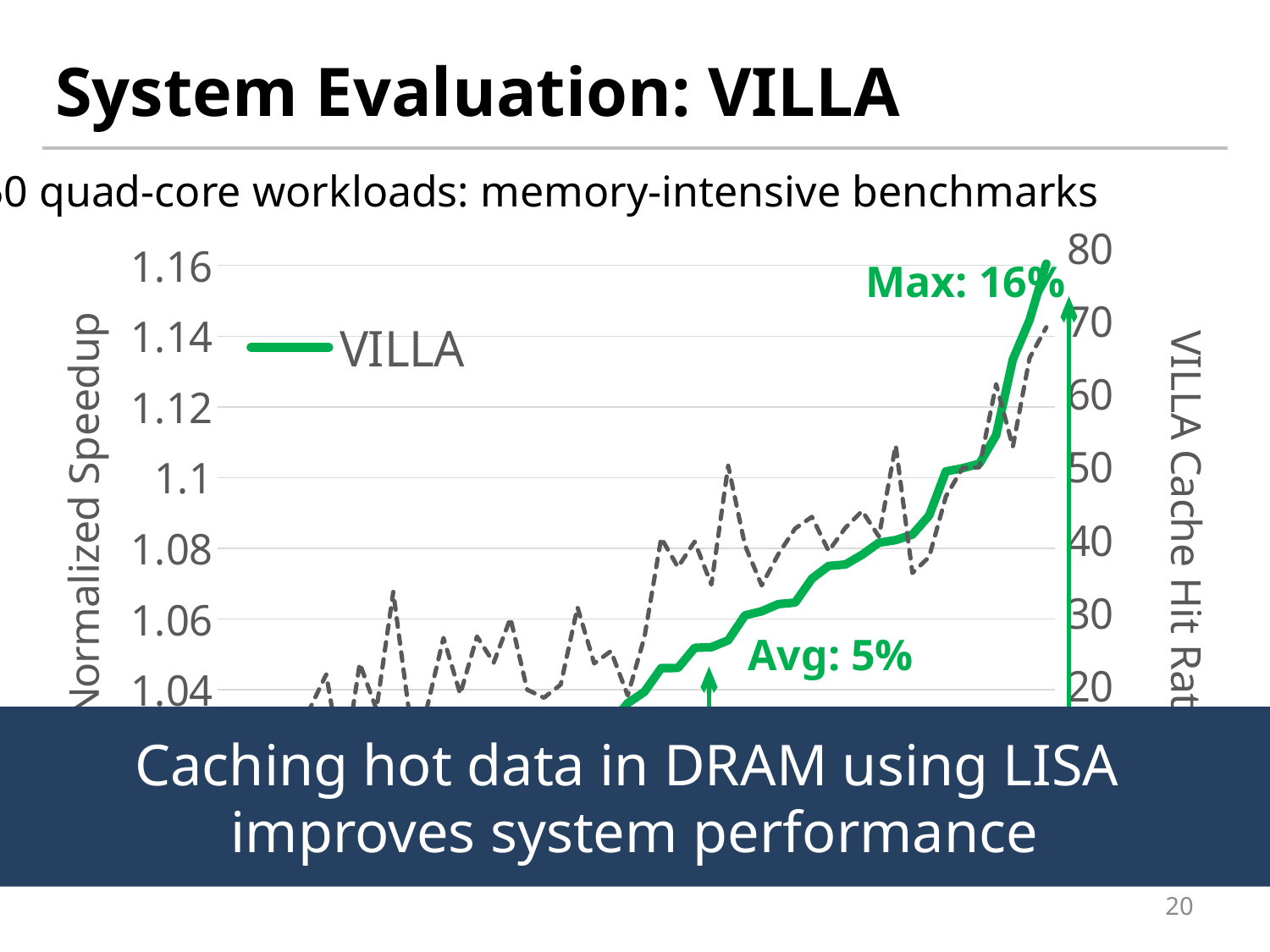
What is the highest tick value shown on the right vertical axis? 80 What kind of chart is shown on the slide? line chart What maximum speedup is annotated on the chart? 16% Is the highest point of the VILLA line greater or less than 1.14 on the left axis? greater What average speedup is annotated on the chart? 5% Does the VILLA line rise or fall from left to right along the x axis? rise What is the highest tick value shown on the left vertical axis? 1.16 What is the name of the series listed in the chart's legend? VILLA What is the label of the left vertical axis of the chart? Normalized Speedup How many series does the chart's legend list? 1